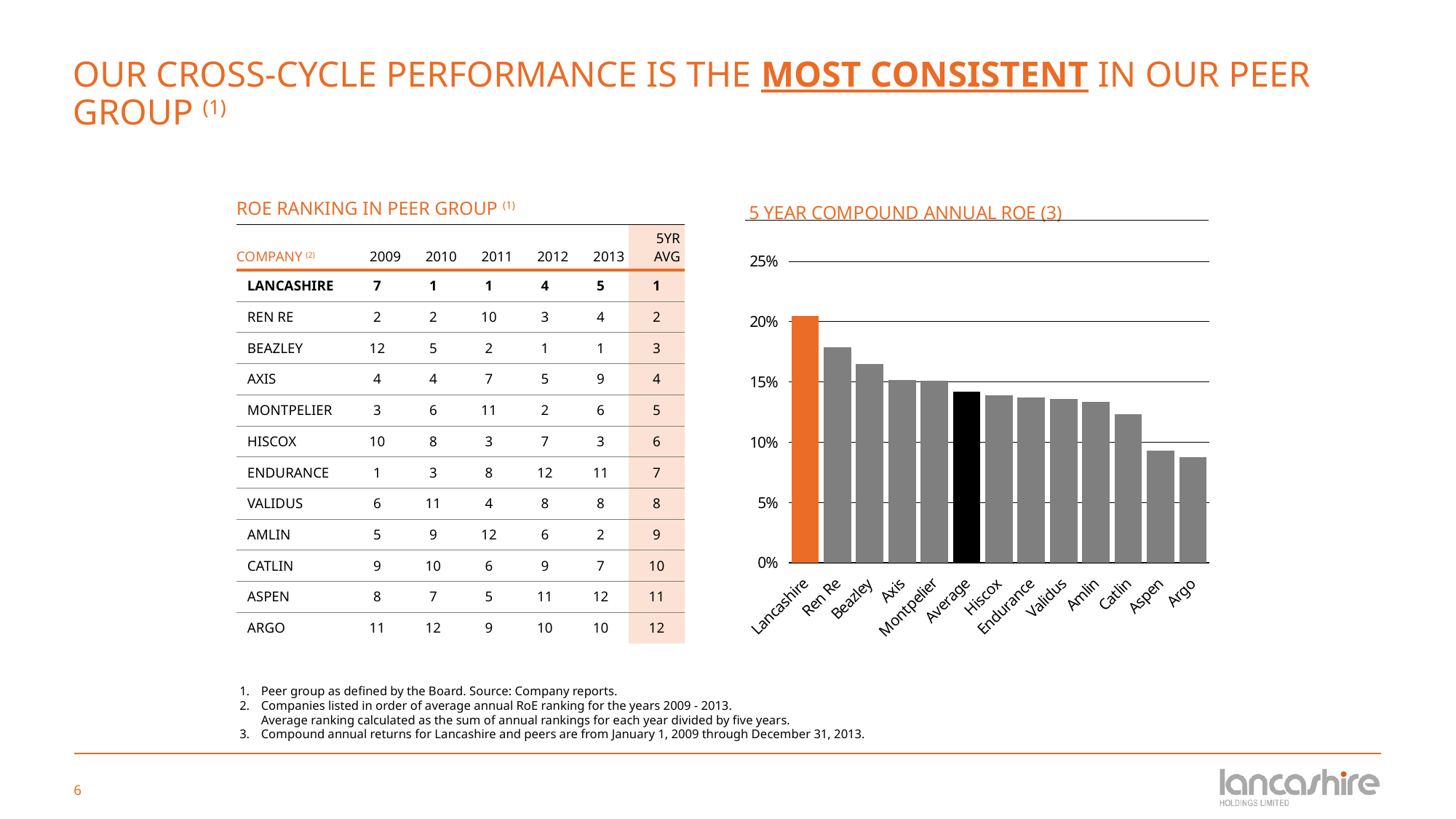
In the 5 YEAR COMPOUND ANNUAL ROE chart, do the bar values rise or fall from left to right? Fall What kind of chart is shown under the title "5 YEAR COMPOUND ANNUAL ROE (3)"? Bar chart In the 5 YEAR COMPOUND ANNUAL ROE chart, which bar is coloured black? Average In the 5 YEAR COMPOUND ANNUAL ROE chart, which company has the highest value? Lancashire In the 5 YEAR COMPOUND ANNUAL ROE chart, which company has the lowest value? Argo In the 5 YEAR COMPOUND ANNUAL ROE chart, is the value for Aspen greater or less than 10%? less In the 5 YEAR COMPOUND ANNUAL ROE chart, is the value for Catlin greater or less than 10%? greater In the 5 YEAR COMPOUND ANNUAL ROE chart, is the value for Beazley greater or less than 20%? less In the 5 YEAR COMPOUND ANNUAL ROE chart, which is larger, the value for Lancashire or the value for Ren Re? Lancashire How many bars are plotted in the 5 YEAR COMPOUND ANNUAL ROE chart? 13 In the 5 YEAR COMPOUND ANNUAL ROE chart, which is larger, the value for Hiscox or the value for Aspen? Hiscox